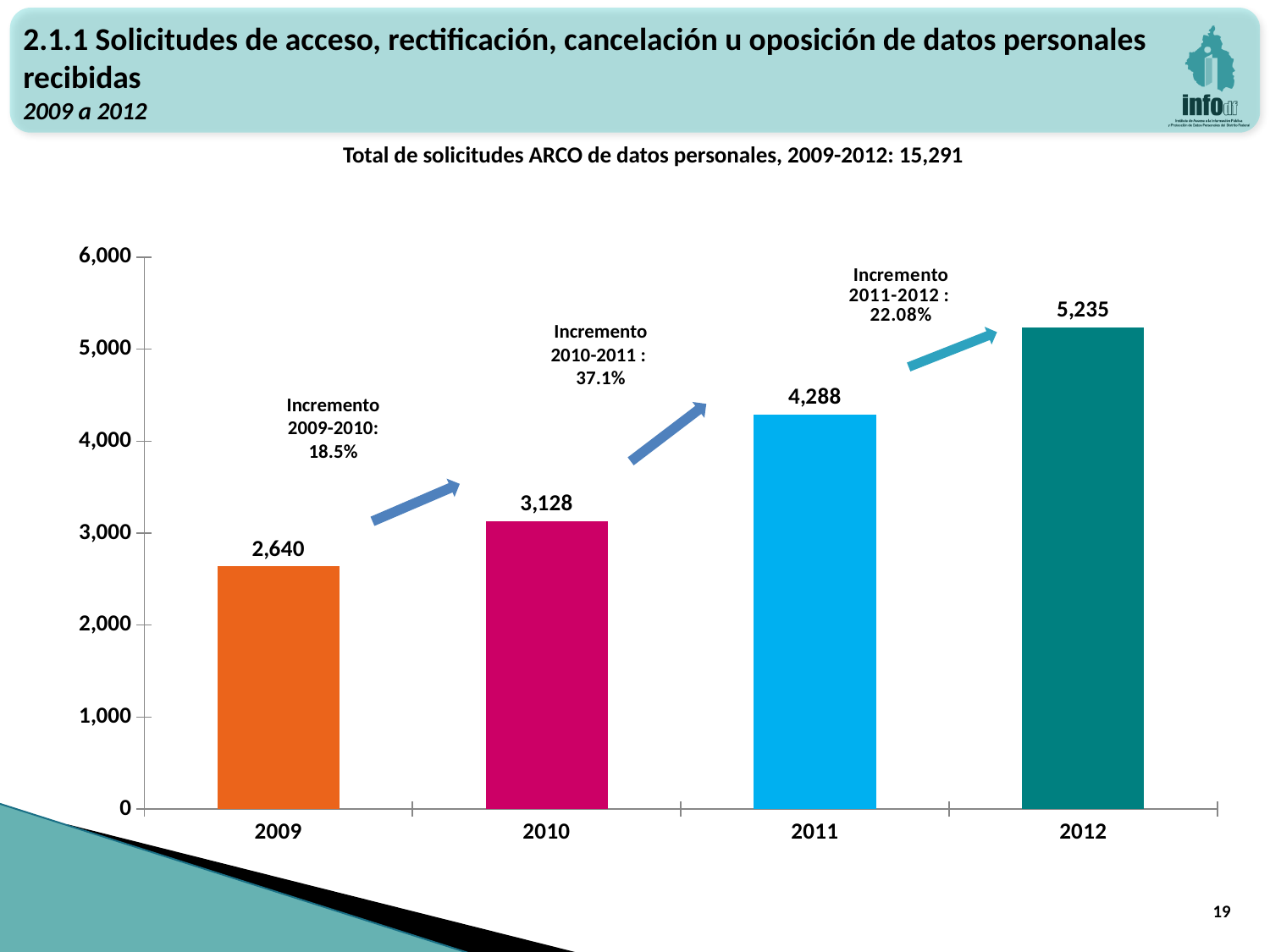
How many years are shown on the x axis? 4 Which year has the highest value? 2012 What is the difference between the values for 2012 and 2011? 947 What is the value for 2011? 4,288 What is the value for 2012? 5,235 Which year has the lowest value? 2009 Do the values rise or fall from 2009 to 2012? rise Is the value for 2010 greater or less than 3,000? greater What is the value for 2009? 2,640 What is the difference between the values for 2010 and 2009? 488 Which is larger, the value for 2010 or the value for 2011? 2011 What kind of chart is shown on the slide? bar chart